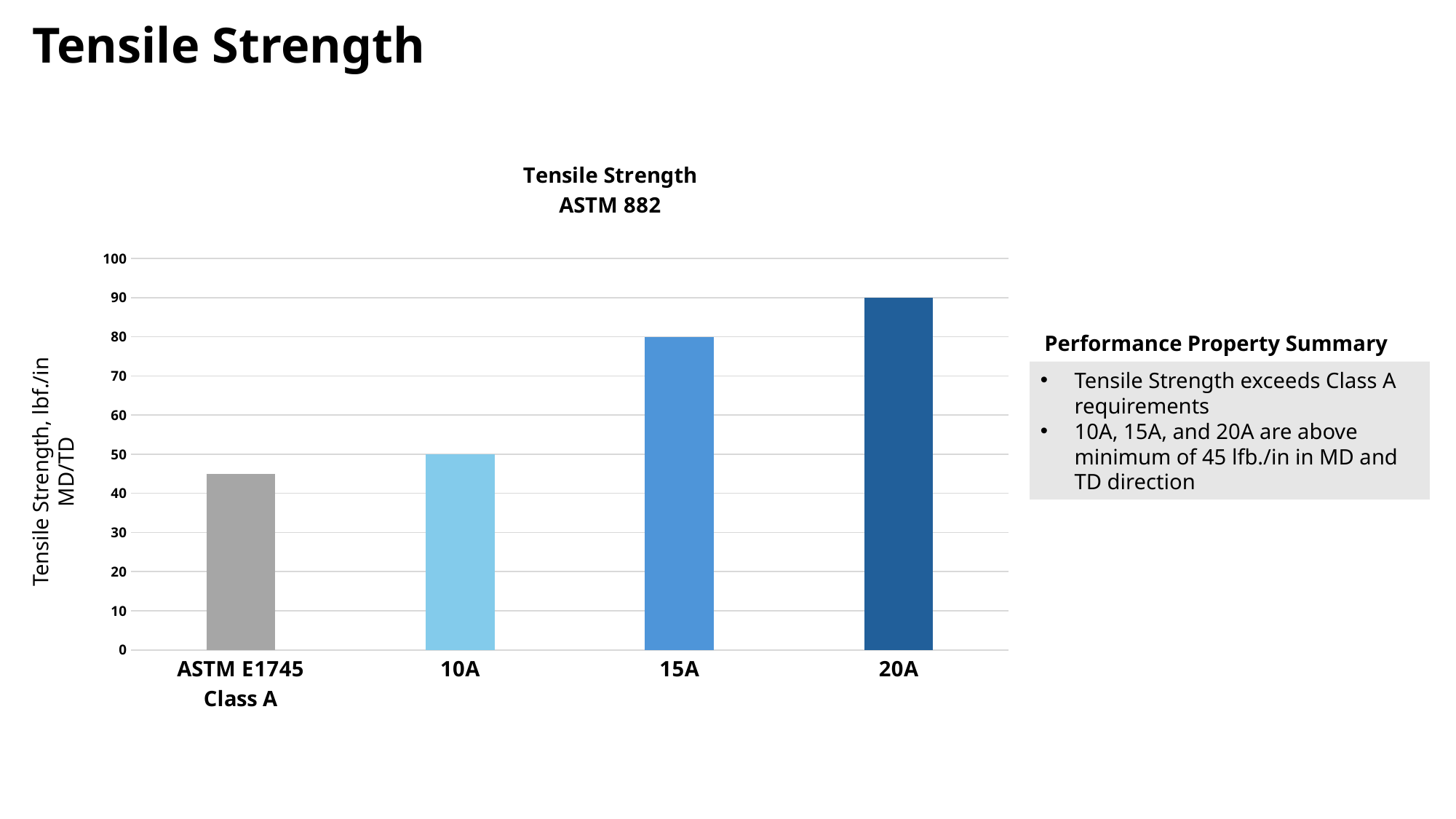
Which category has the lowest tensile strength? ASTM E1745 Class A How many bars are shown in the chart? 4 Which has a higher tensile strength, 10A or 15A? 15A Which category has the highest tensile strength? 20A What is the difference in tensile strength between 20A and 15A? 10 What is the tensile strength value for 10A? 50 What is the tensile strength value for 15A? 80 Do the values rise or fall from left to right across the categories? rise What is the tensile strength value for 20A? 90 What is the difference in tensile strength between 15A and 10A? 30 Is the value for ASTM E1745 Class A greater or less than 50? less What kind of chart is shown on the slide? bar chart